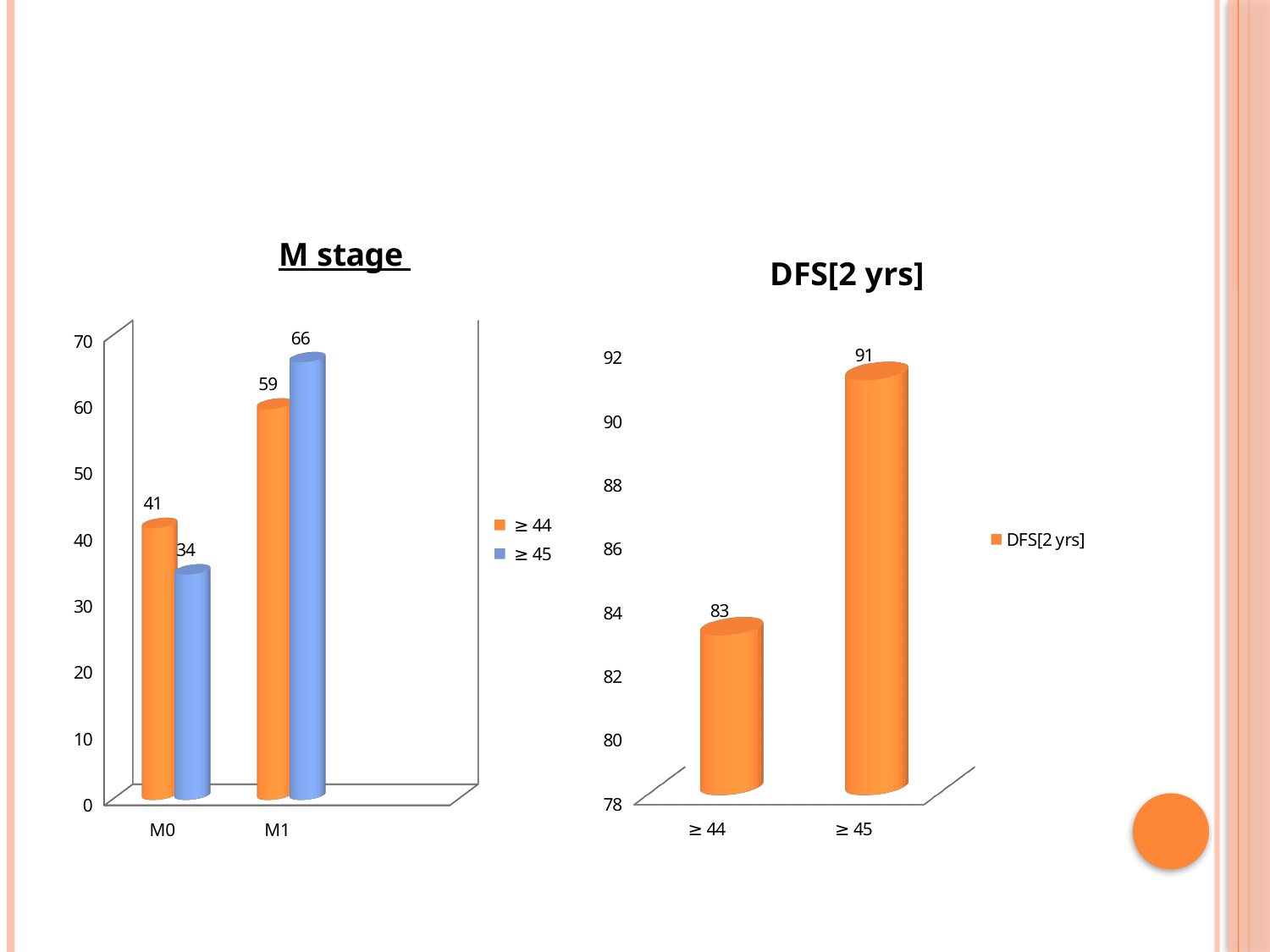
How many series does the legend of the M stage chart list? 2 In the DFS[2 yrs] chart, what is the value for ≥ 45? 91 In the M stage chart, what is the difference between the ≥ 45 and ≥ 44 values at M1? 7 In the DFS[2 yrs] chart, which category has the lowest value? ≥ 44 In the M stage chart, what is the value for the ≥ 44 series at M0? 41 In the M stage chart, what is the value for the ≥ 45 series at M1? 66 In the M stage chart, which is larger at M0: the ≥ 44 value or the ≥ 45 value? ≥ 44 In the M stage chart, what is the value for the ≥ 45 series at M0? 34 In the M stage chart, which category has the highest value for the ≥ 44 series? M1 In the DFS[2 yrs] chart, what is the difference between the ≥ 45 and ≥ 44 values? 8 What kind of chart is the DFS[2 yrs] chart? Bar chart How many categories are shown on the x axis of the M stage chart? 2